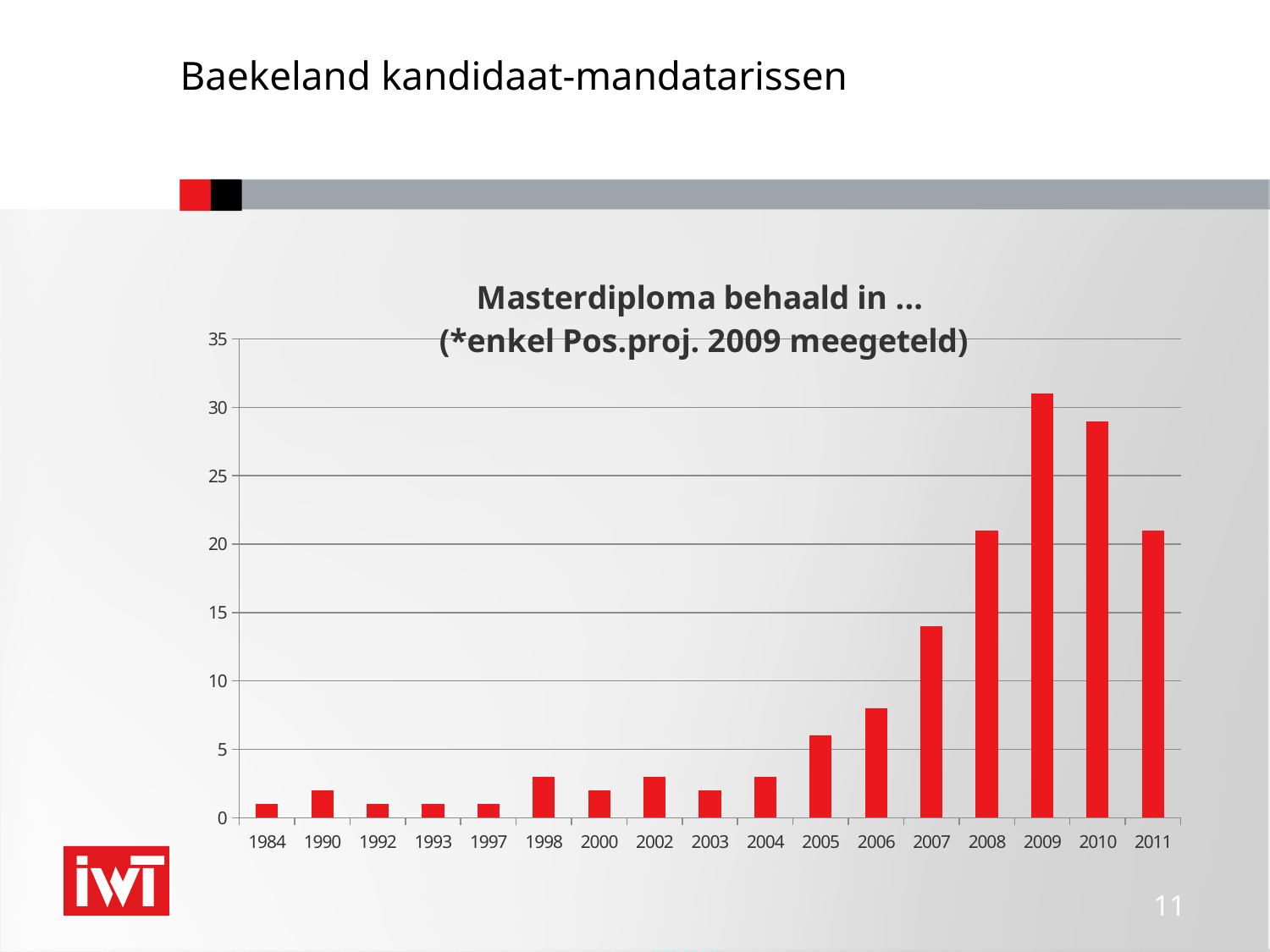
Do the values rise or fall from 2004 to 2009? rise What kind of chart is shown on the slide? bar chart Is the value for 2008 greater or less than 20? greater Is the value for 2007 greater or less than 10? greater Which is larger, the value for 2010 or the value for 2011? 2010 Is the value for 2005 greater or less than 5? greater Which is larger, the value for 2007 or the value for 2008? 2008 How many years are shown on the x axis of the chart? 17 Which year has the highest bar in the chart? 2009